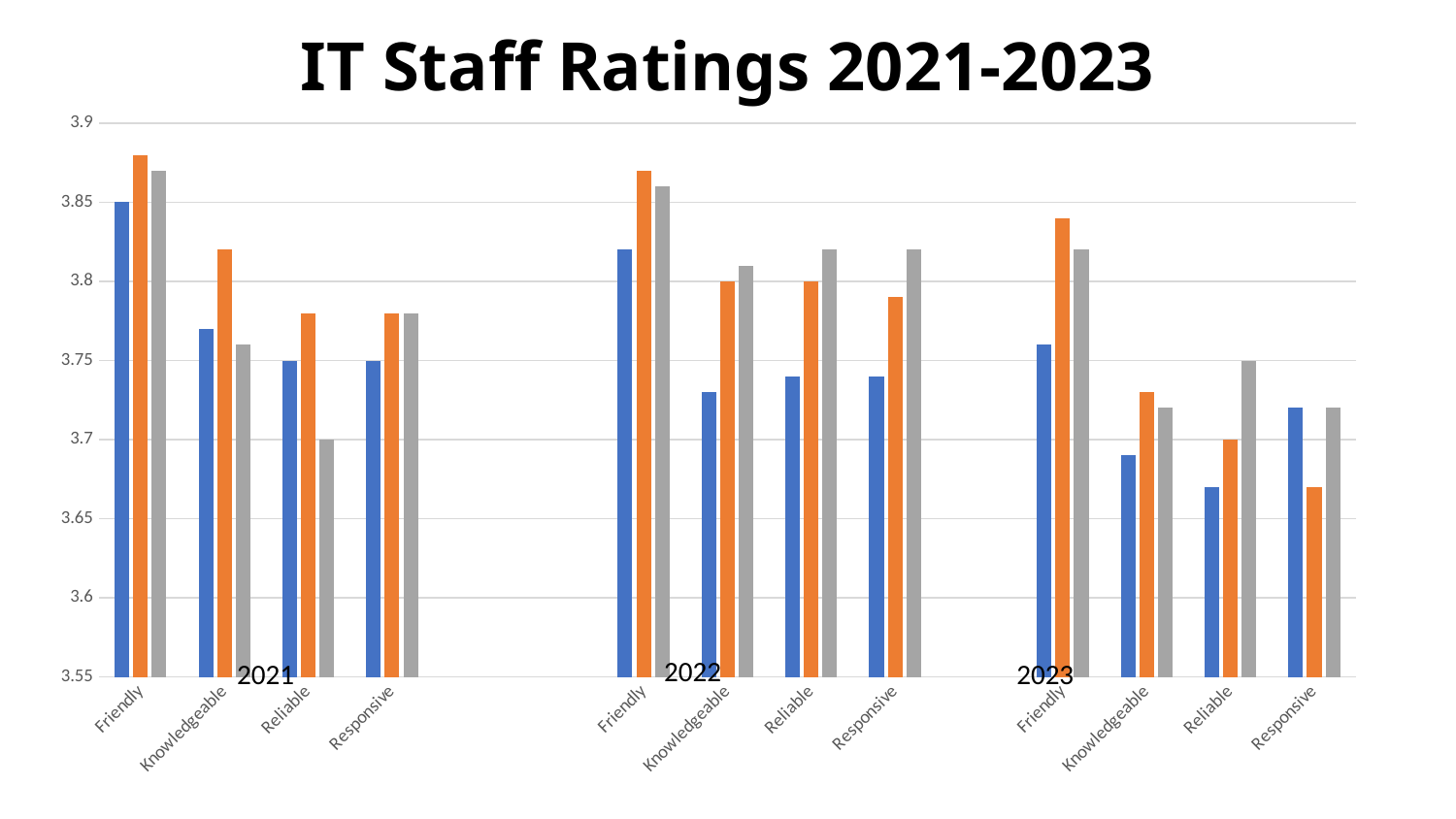
How many rating categories are shown for each year? 4 Does the blue bar for Friendly rise or fall from 2021 to 2023? fall What kind of chart is shown on the slide? bar chart Which rating category has the tallest bars in every year? Friendly Is the orange bar for Knowledgeable in 2022 greater or less than 3.75? greater How many bars are shown for each rating category? 3 Is the gray bar for Reliable in 2021 greater or less than 3.75? less Is the orange bar for Friendly in 2021 greater or less than 3.85? greater Which rating category has the lowest bar in the 2021 group? Reliable In 2023, which is higher for Reliable: the orange bar or the gray bar? the gray bar What is the title of the chart? IT Staff Ratings 2021-2023